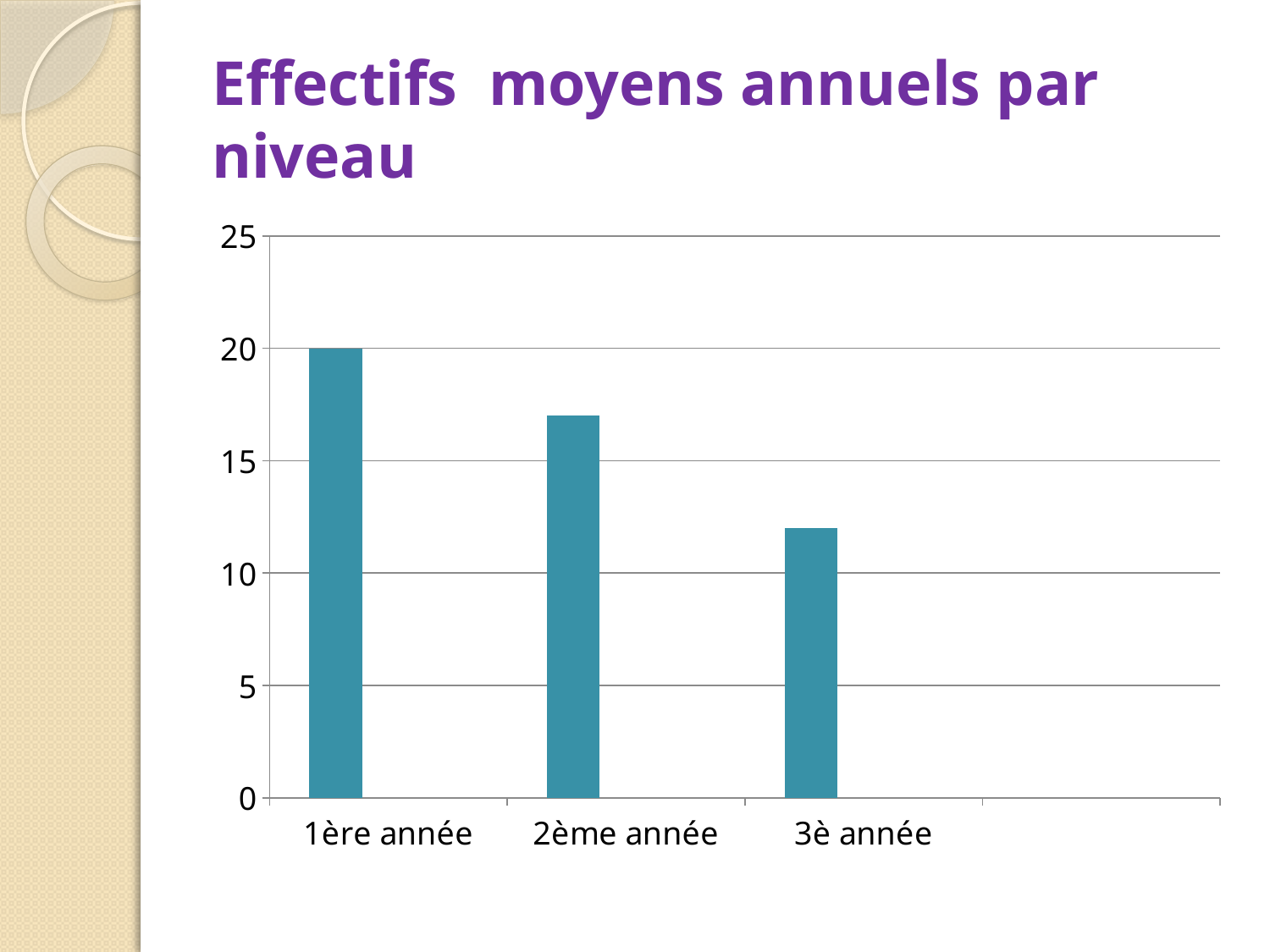
How many categories are shown on the x axis? 3 Which is larger, the value for 2ème année or the value for 3è année? 2ème année What is the value for 1ère année? 20 Is the value for 3è année greater or less than 10? greater Do the values rise or fall from 1ère année to 3è année? fall Is the value for 2ème année greater or less than 15? greater Which category has the highest value? 1ère année What kind of chart is shown on the slide? bar chart Which category has the lowest value? 3è année Is the value for 2ème année greater or less than 20? less What is the title of the slide? Effectifs moyens annuels par niveau